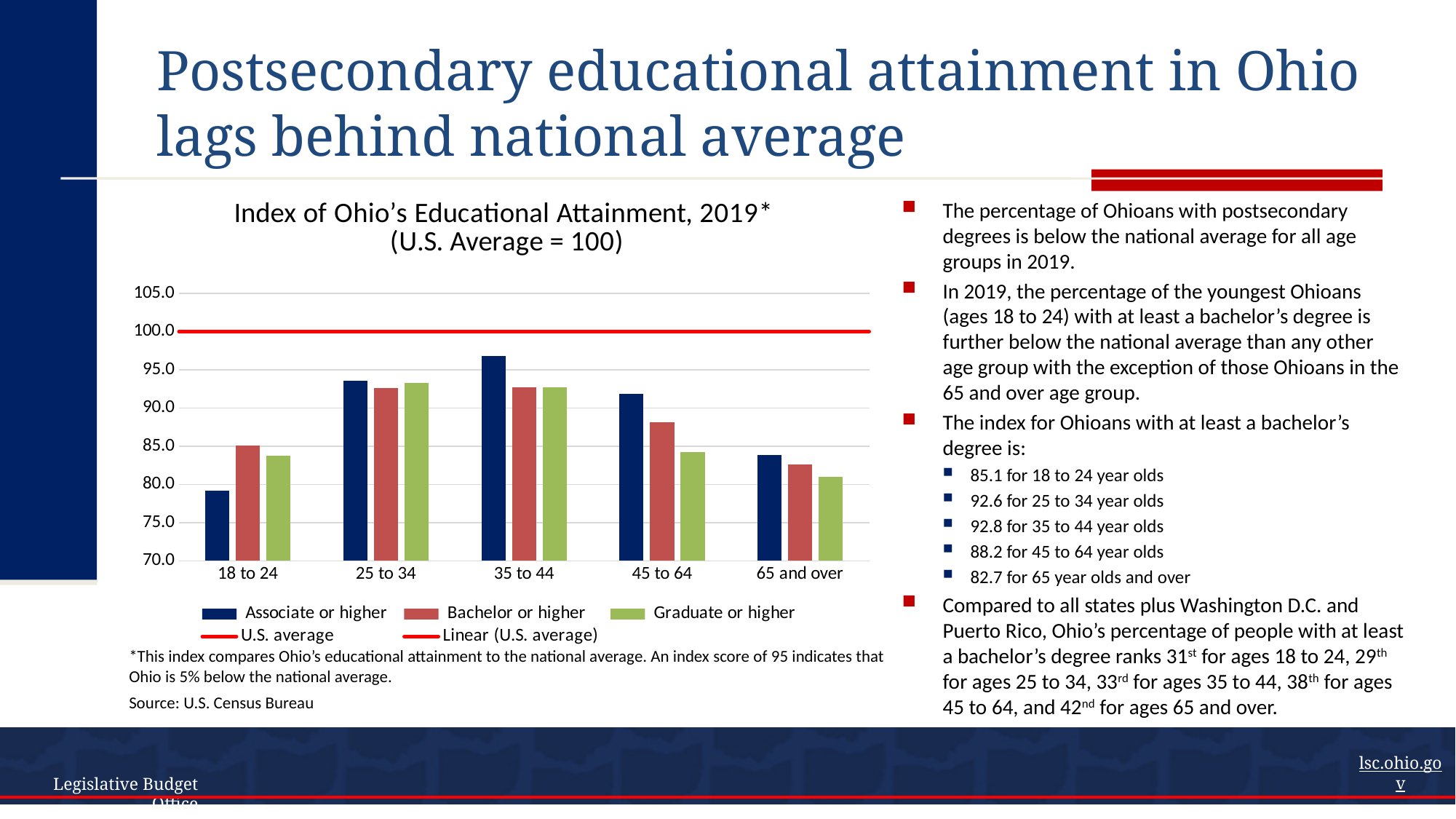
What is the index value for Bachelor or higher for the 45 to 64 age group? 88.2 How many entries does the chart's legend list? 5 How many age-group categories are shown on the x axis of the chart? 5 For the 18 to 24 age group, which is larger: the Associate or higher value or the Bachelor or higher value? Bachelor or higher What is the difference between the Bachelor or higher index for 35 to 44 year olds and for 18 to 24 year olds? 7.7 What is the index value for Bachelor or higher for the 18 to 24 age group? 85.1 Which age group has the highest Associate or higher index value? 35 to 44 Is the Associate or higher value for the 18 to 24 age group greater or less than 80.0? less What is the index value for Bachelor or higher for the 65 and over age group? 82.7 What type of chart is shown on the slide? bar chart What value does the red horizontal line labelled U.S. average sit at? 100.0 Which age group has the lowest Associate or higher index value? 18 to 24